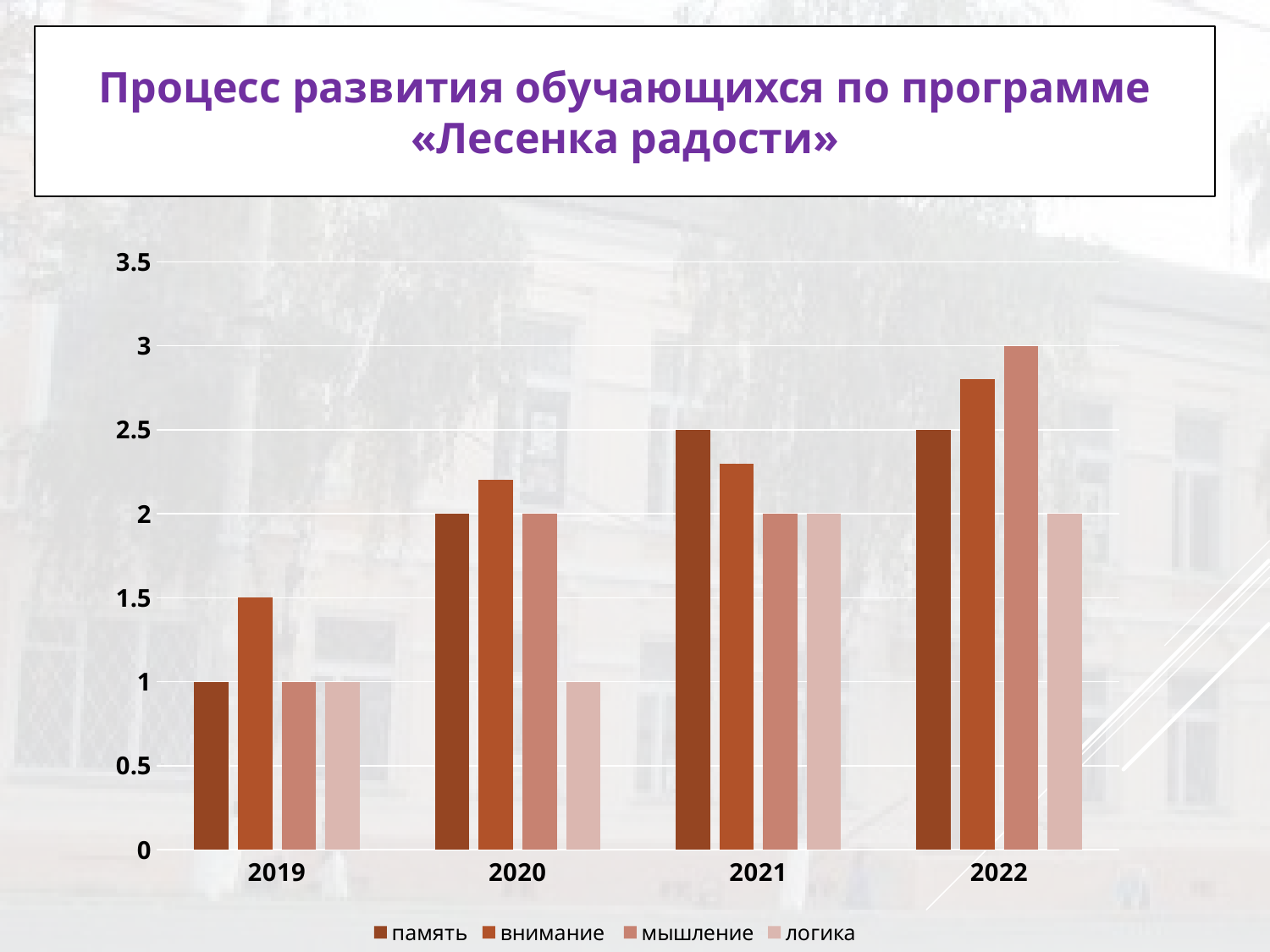
How many series does the legend list? 4 Is the value for внимание in 2022 greater or less than 2.5? greater Which series has the lowest value in 2020? логика What kind of chart is shown on the slide? bar chart What is the value for логика in 2020? 1 Which series has the highest value in 2022? мышление What is the value for внимание in 2019? 1.5 What is the value for память in 2021? 2.5 What is the value for мышление in 2022? 3 Does the value for память rise or fall from 2019 to 2021? rise How many years are shown on the x axis? 4 Is the value for внимание in 2020 greater or less than 2.5? less